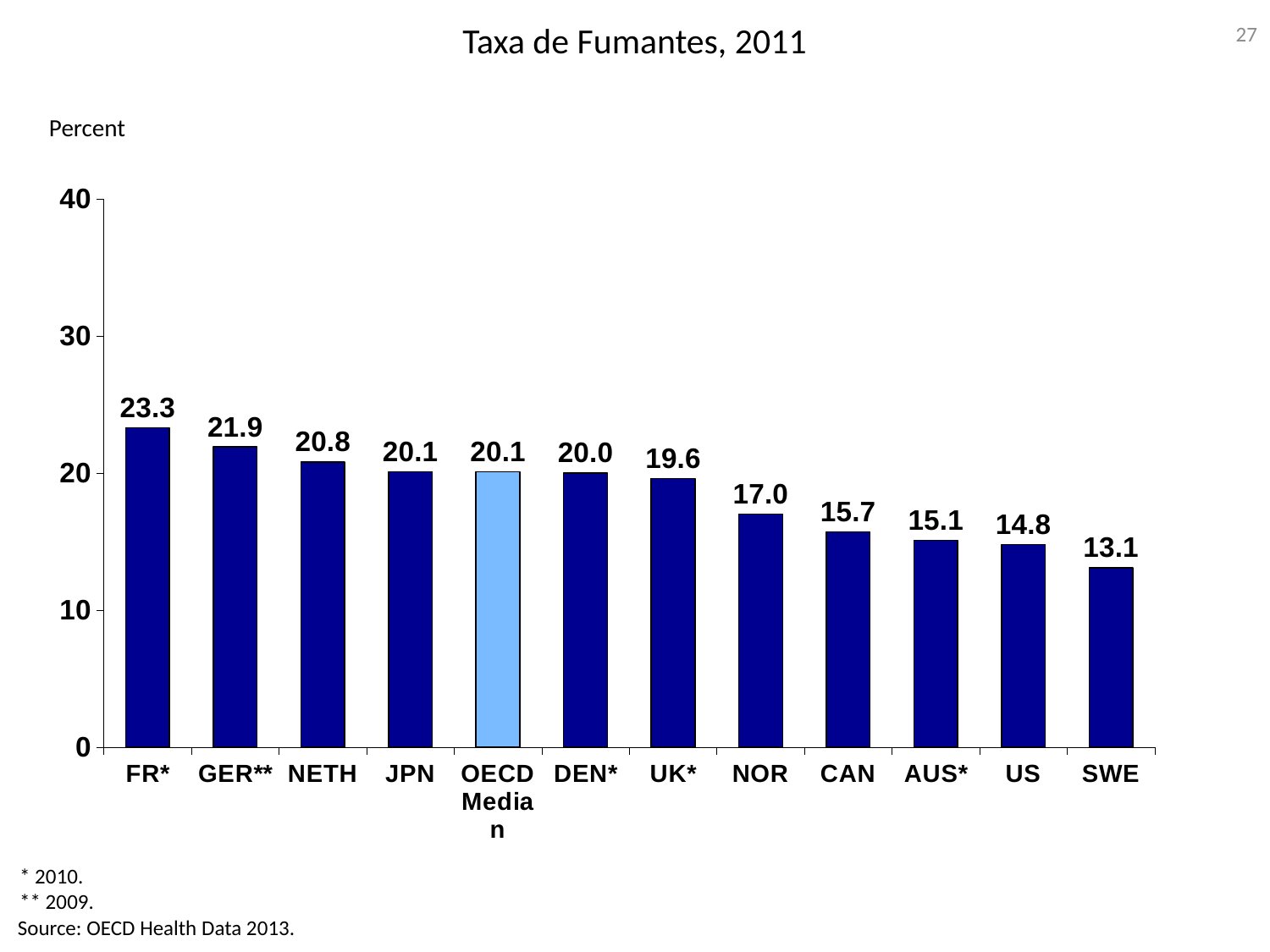
What is the value for SWE? 13.1 Which category has the highest value? FR* What is the difference between the values for US and SWE? 1.7 Which is larger, the value for NOR or the value for CAN? NOR What is the value for the OECD Median? 20.1 What kind of chart is this? bar chart Do the values rise or fall from left to right along the x axis? fall What is the difference between the values for FR* and GER**? 1.4 Which category has the lowest value? SWE What is the value for FR*? 23.3 How many categories are shown on the x axis? 12 Is the value for UK* greater or less than 20? less